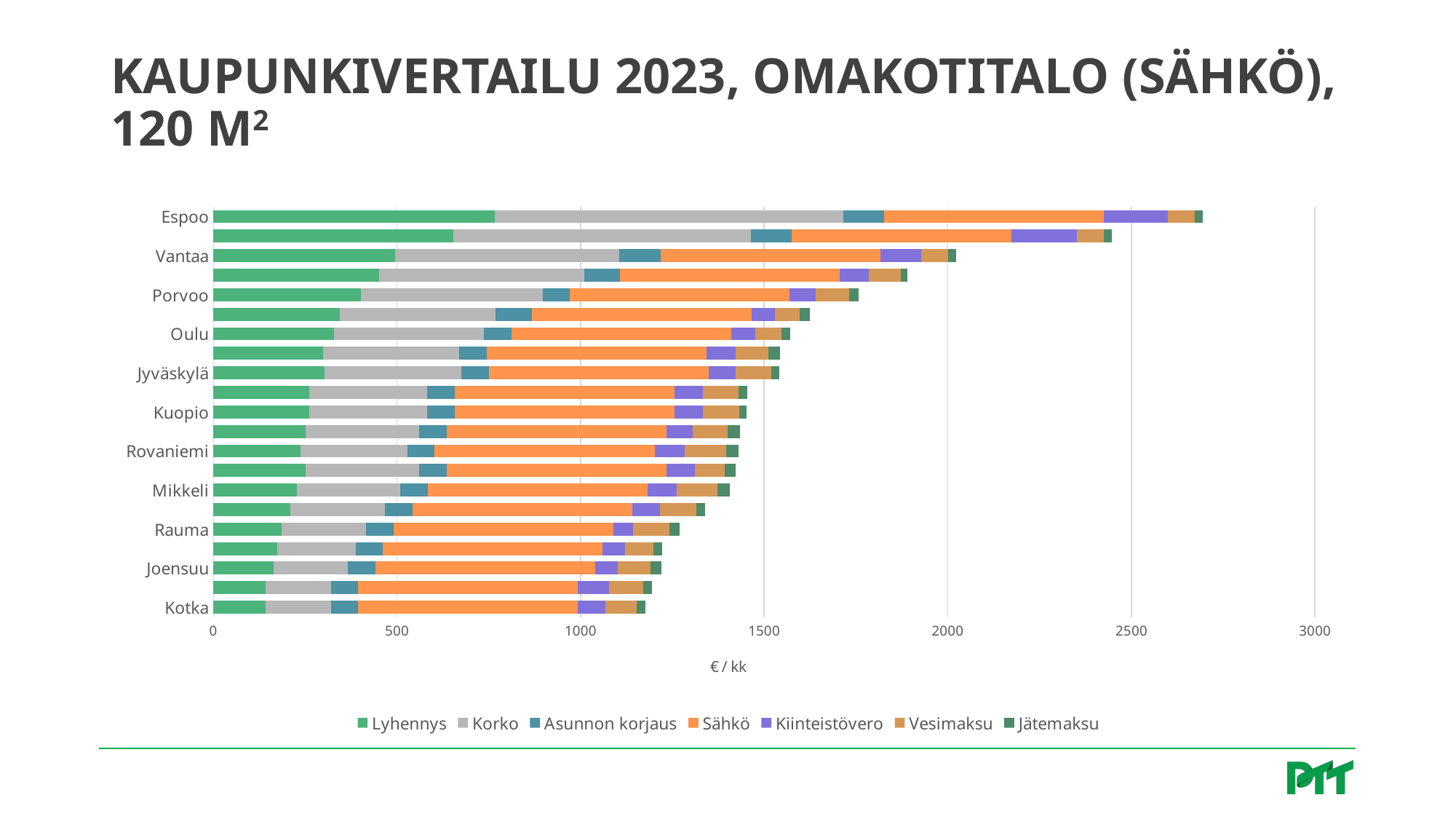
Is the total value for Kotka greater or less than 1500? less Is the total value for Espoo greater or less than 2500? greater What unit is shown on the horizontal axis label? € / kk What kind of chart is shown on the slide? Stacked bar chart Which labelled city has the longest total bar? Espoo Is the total value for Kuopio greater or less than 1500? less Which labelled city has the shortest total bar? Kotka Which has the larger total bar, Vantaa or Oulu? Vantaa How many series does the legend list? 7 Which has the larger total bar, Rauma or Mikkeli? Mikkeli